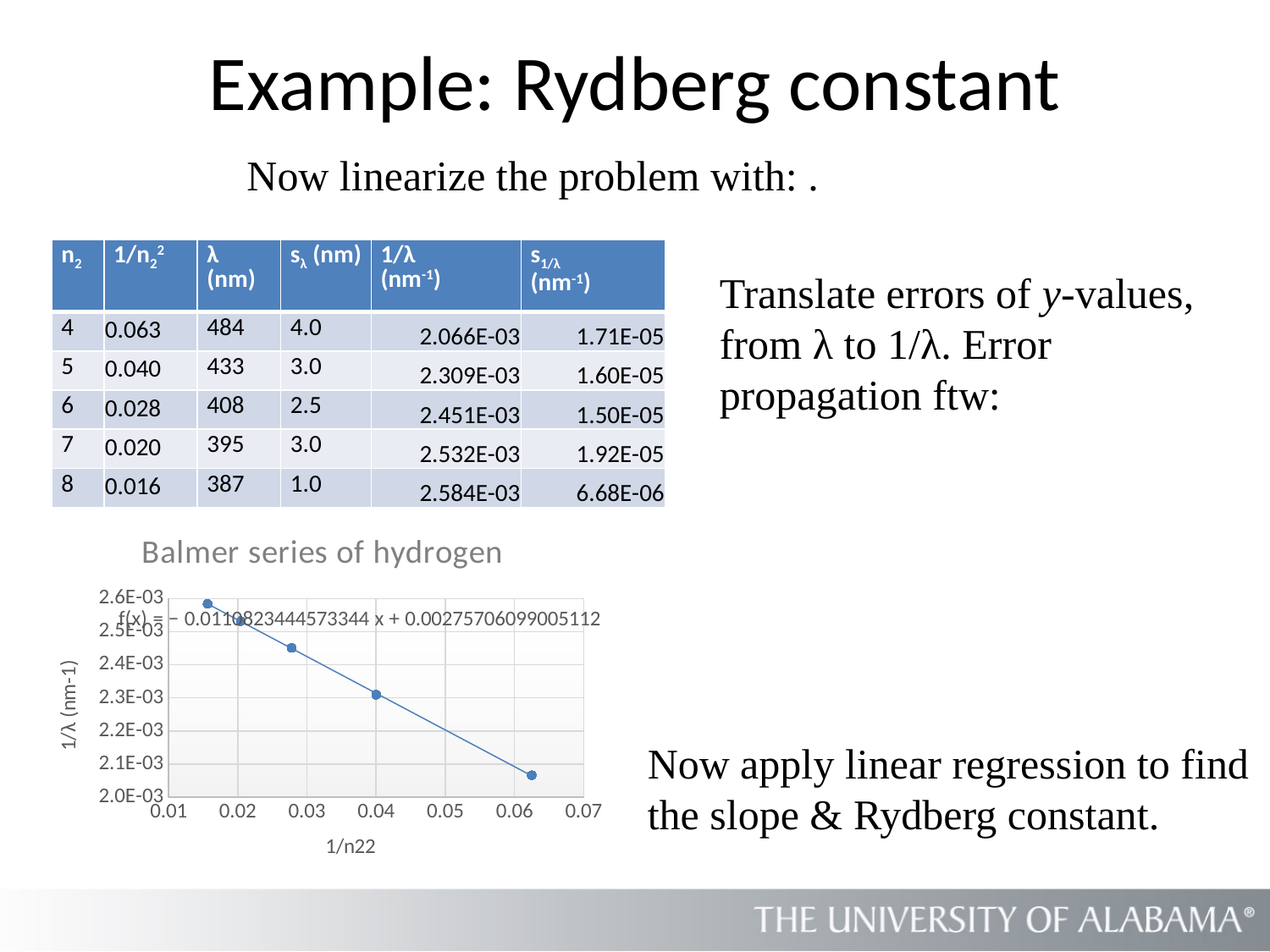
Is the value of 1/λ for the point at about 0.03 on the x axis greater or less than 2.4E-03? greater What is the label of the y axis of the chart? 1/λ (nm-1) What is the intercept of the fitted line shown in the chart's trendline equation? 0.00275706099005112 What is the title of the chart on the slide? Balmer series of hydrogen Do the plotted values rise or fall as 1/n22 increases along the x axis? fall Is the value of 1/λ for the point at about 0.06 on the x axis greater or less than 2.1E-03? less What is the slope of the fitted line shown in the chart's trendline equation? −0.0110823444573344 How many data points are plotted in the chart? 5 What kind of chart is shown on the slide? scatter chart Is the value of 1/λ for the point at about 0.04 on the x axis greater or less than 2.4E-03? less Which point has the highest 1/λ value: the leftmost point or the rightmost point? the leftmost point